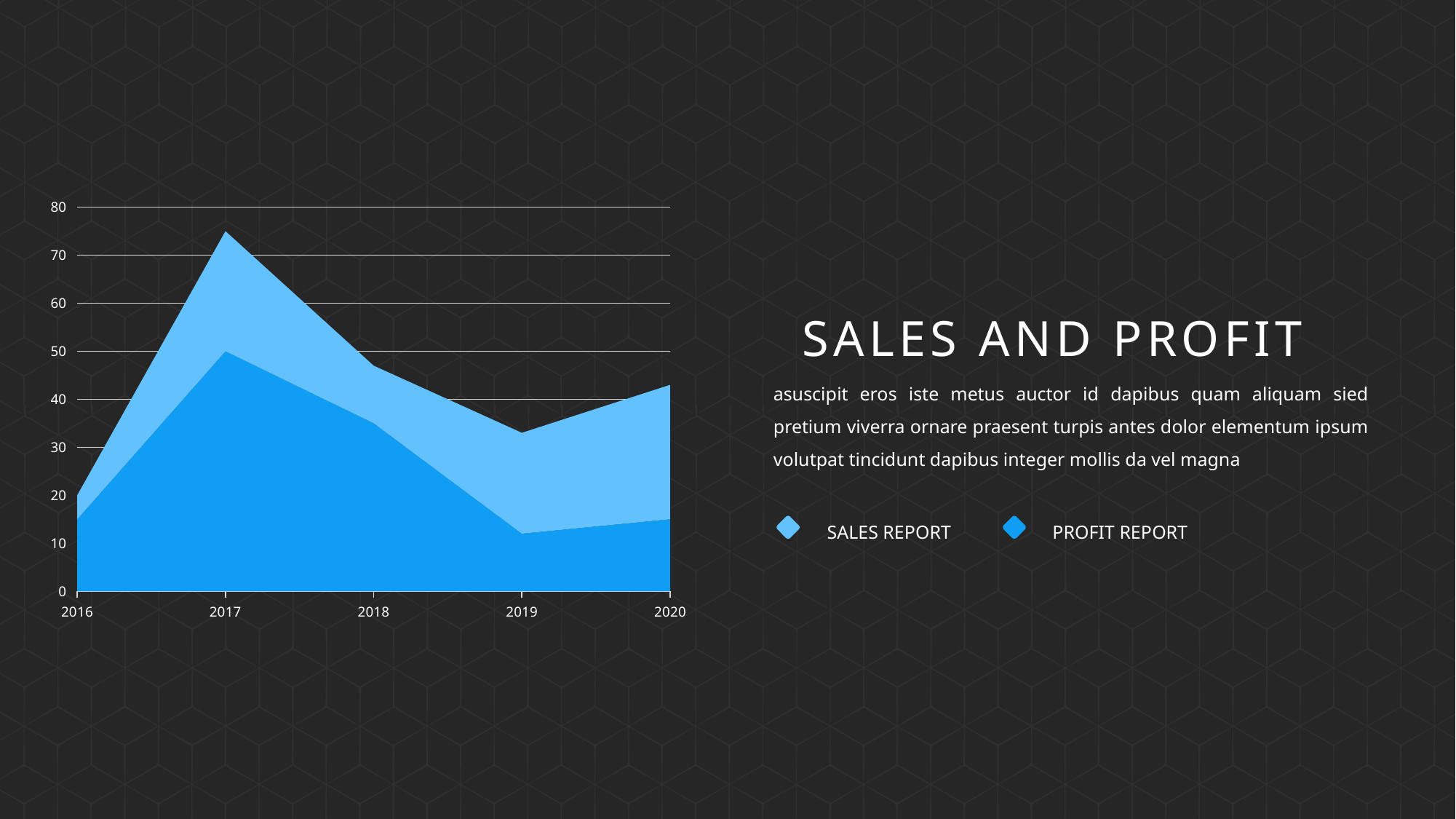
Is the Sales Report value for 2017 greater or less than 70? less Which is larger, the Sales Report value for 2018 or for 2019? 2019 Is the Profit Report value for 2019 greater or less than 20? less In which year is the Sales Report value lowest? 2016 What is the title shown next to the chart? SALES AND PROFIT In which year does the Profit Report series reach its highest value? 2017 How many series does the legend list? 2 Does the Sales Report series rise or fall from 2017 to 2019? Fall Is the Sales Report value for 2019 greater or less than 30? less How many years are shown on the x axis of the chart? 5 What kind of chart is shown on the slide? Area chart